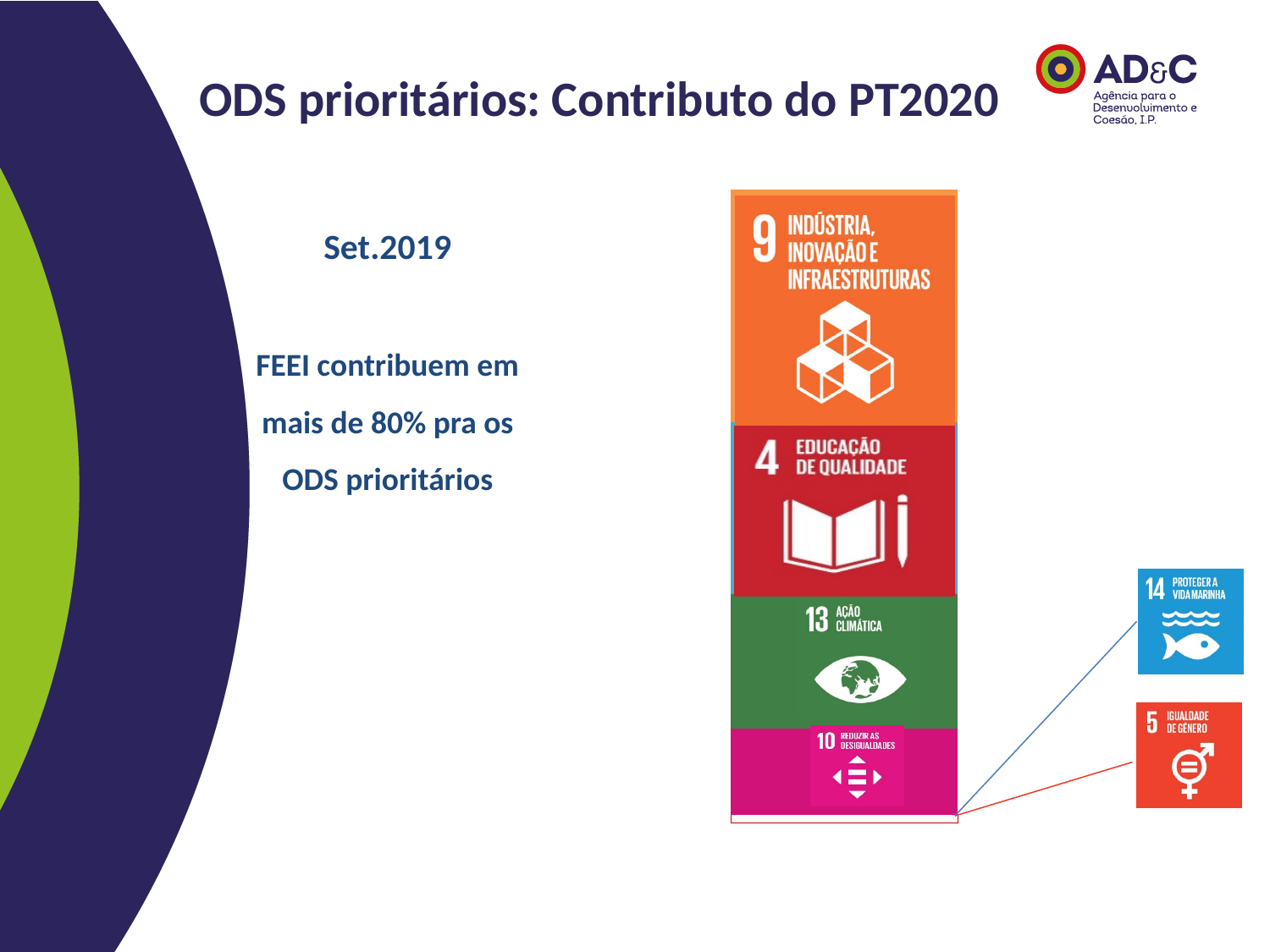
What is the title of the slide containing the chart? ODS prioritários: Contributo do PT2020 Which segment is larger in the stacked bar: ODS 9 or ODS 10? ODS 9 Which segment is larger in the stacked bar: ODS 4 (Educação de Qualidade) or ODS 13 (Ação Climática)? ODS 4 Which two ODS are shown in the callouts pointing to the very bottom of the stacked bar? ODS 14 and ODS 5 What kind of chart is shown on the slide? Stacked bar chart Which ODS segment is at the top of the stacked bar? ODS 9 Which ODS occupies the largest segment of the stacked bar? ODS 9 (Indústria, Inovação e Infraestruturas) Which segment is larger in the stacked bar: ODS 13 or ODS 10? ODS 13 According to the slide text, the FEEI contribute more than what percentage to the priority ODS? 80% How many ODS segments make up the stacked bar, including the two small ones indicated by callouts? 6